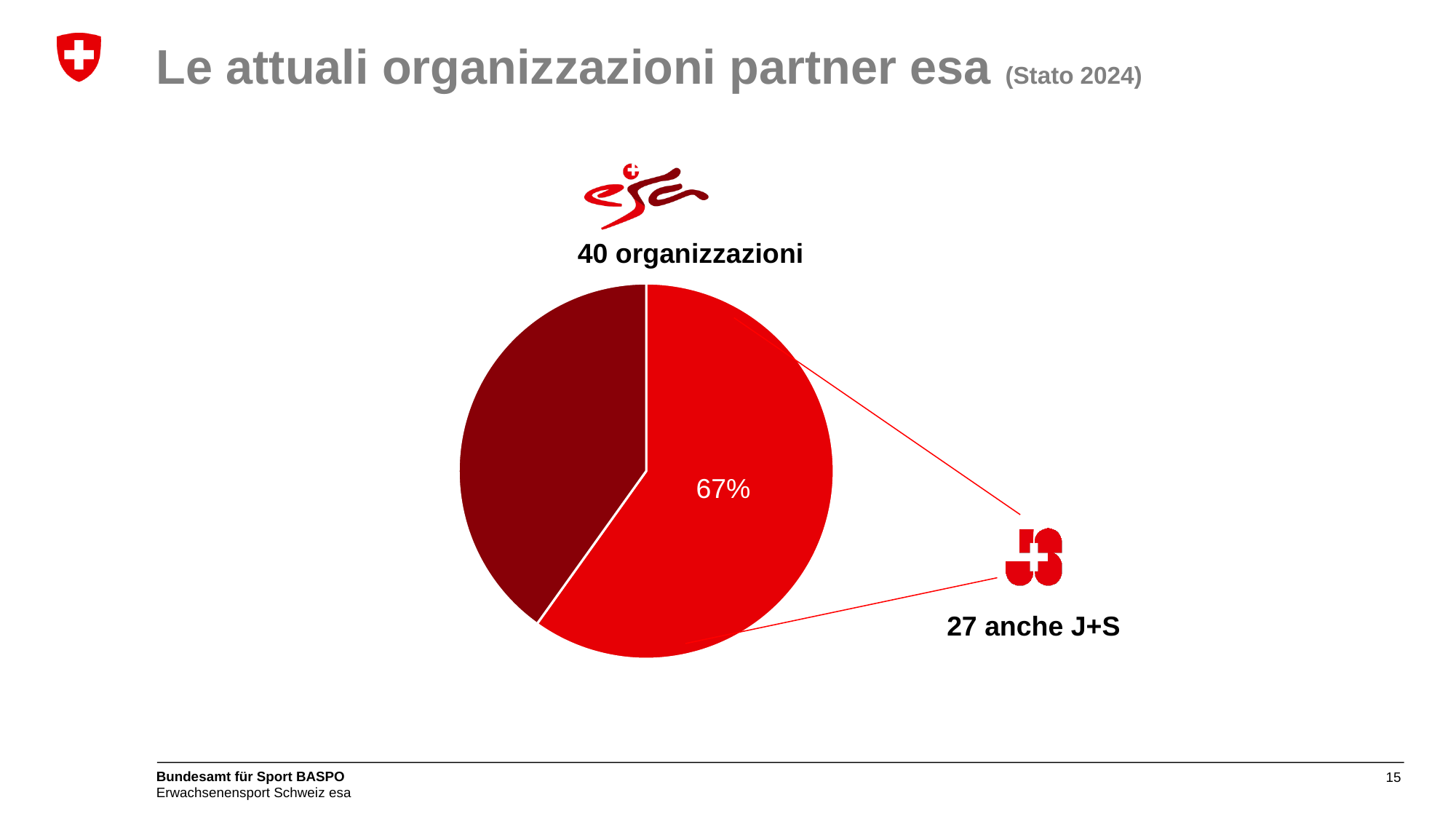
What kind of chart is shown on the slide? Pie chart How many of the 40 organizations are not also J+S (40 minus 27)? 13 What is the title of the slide containing the pie chart? Le attuali organizzazioni partner esa (Stato 2024) How many slices does the pie chart have? 2 What percentage is printed on the bright red slice of the pie chart? 67% What share of the pie does the slice linked to the J+S logo represent? 67% Which slice of the pie chart is larger, the bright red slice or the dark red slice? The bright red slice What colour is the slice of the pie chart that carries the 67% label? Bright red Is the dark red slice of the pie chart greater or less than 50% of the pie? less How many of the partner organizations are also J+S, according to the label next to the pie chart? 27 How many organizations in total does the pie chart represent, according to the label above it? 40 organizzazioni